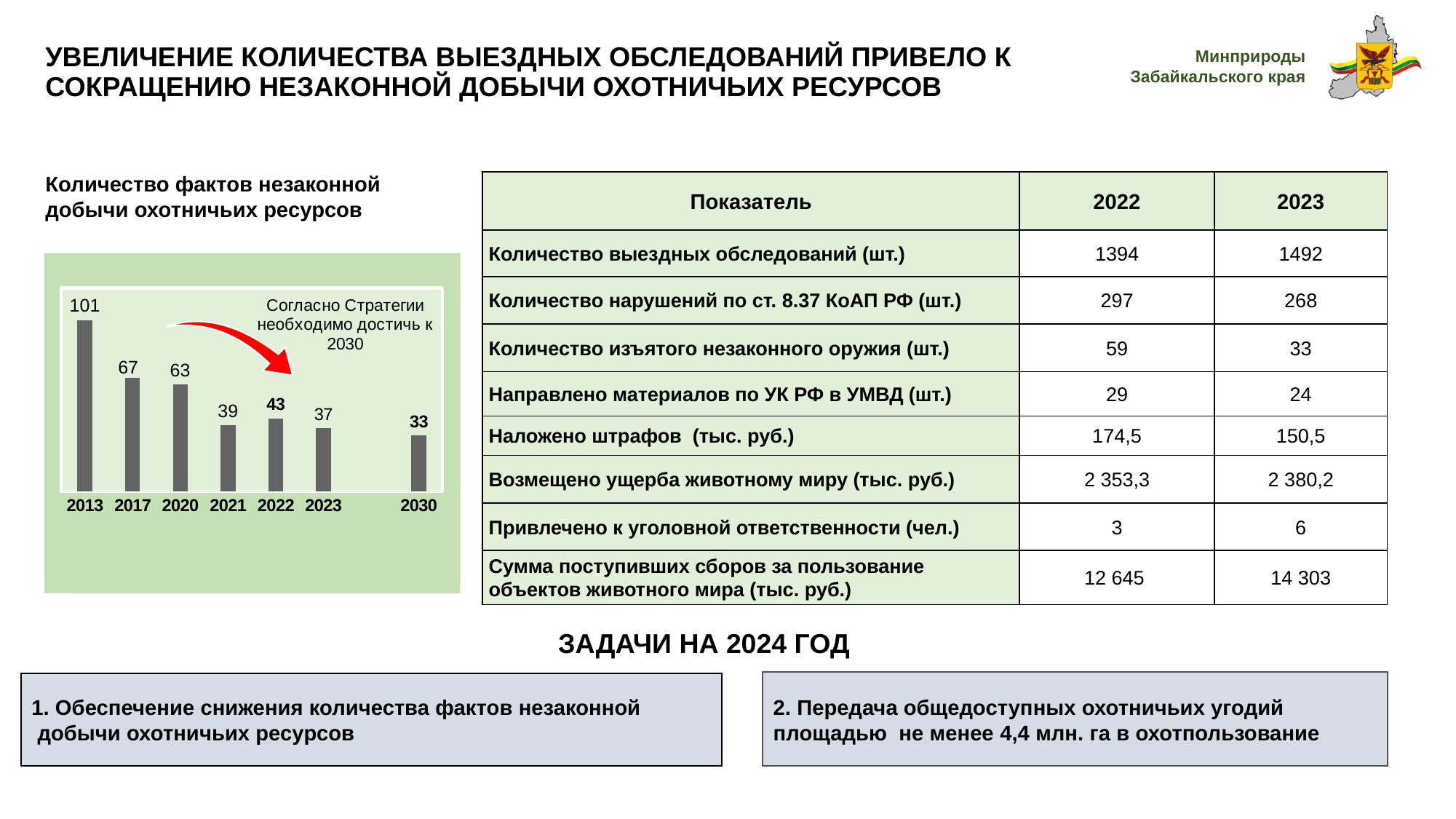
Which year has the highest value in the chart? 2013 How many years (bars) are shown in the chart? 7 What is the value for 2013 in the chart 'Количество фактов незаконной добычи охотничьих ресурсов'? 101 What is the title of the chart on the slide? Количество фактов незаконной добычи охотничьих ресурсов Which is larger in the chart, the value for 2021 or the value for 2022? 2022 What is the value shown for 2030 in the chart? 33 What is the value for 2022 in the chart? 43 What is the difference between the values for 2017 and 2020 in the chart? 4 Which year has the lowest value in the chart? 2030 What is the difference between the values for 2013 and 2023 in the chart? 64 What kind of chart is shown on the slide? Bar chart Do the values in the chart generally rise or fall from 2013 to 2030? Fall